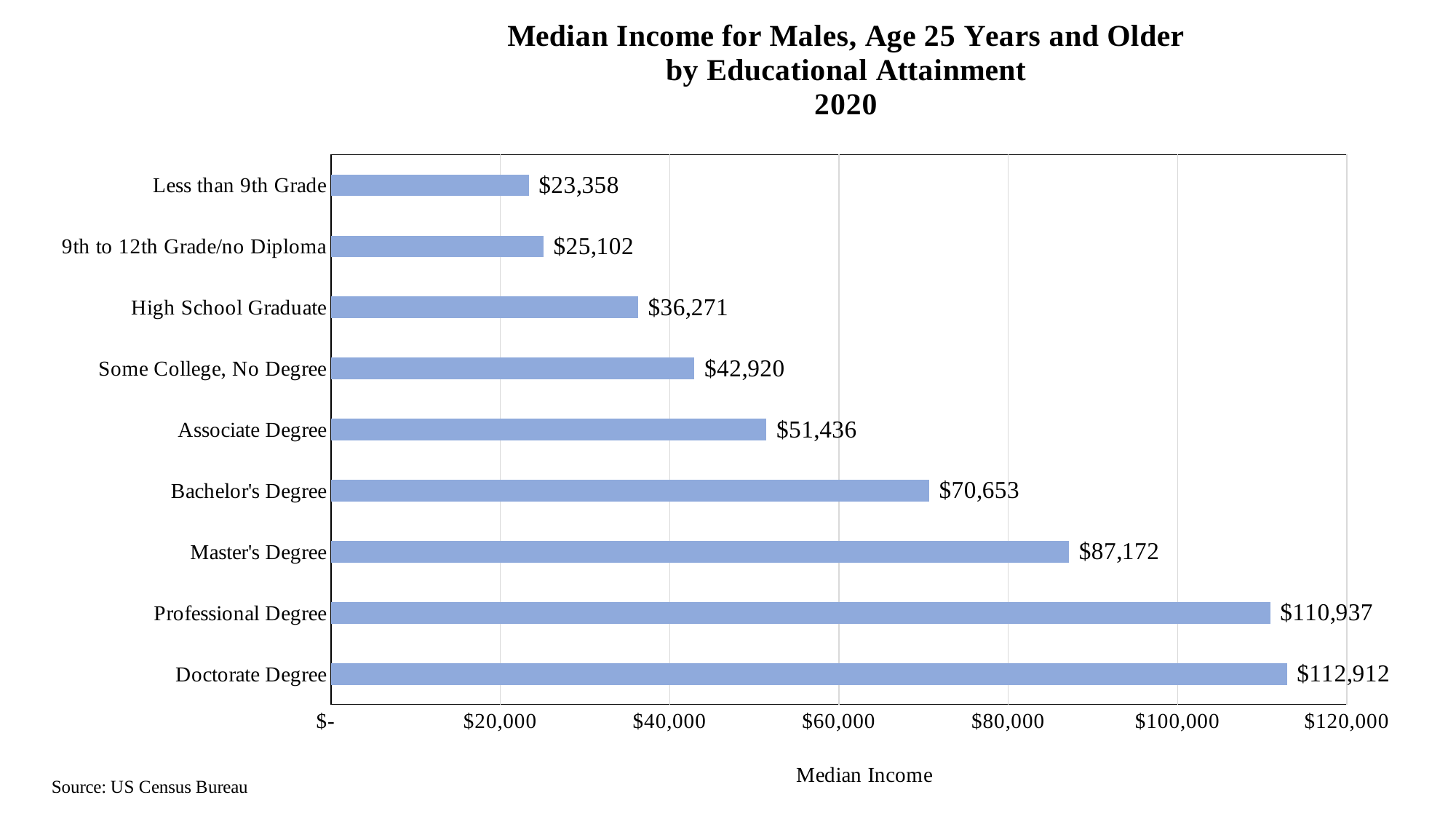
Is the median income for a Master's Degree greater or less than $80,000? greater How many educational attainment categories are shown in the chart? 9 Which educational attainment category has the lowest median income? Less than 9th Grade Which has a higher median income: Associate Degree or Some College, No Degree? Associate Degree What is the difference in median income between a Doctorate Degree and a Professional Degree? $1,975 What is the median income for males with Less than 9th Grade education? $23,358 Which educational attainment category has the highest median income? Doctorate Degree What type of chart is shown on the slide? Bar chart What is the source cited for the chart's data? US Census Bureau What is the median income for males who are High School Graduates? $36,271 What is the median income for males with a Bachelor's Degree? $70,653 What is the difference in median income between a Master's Degree and a Bachelor's Degree? $16,519